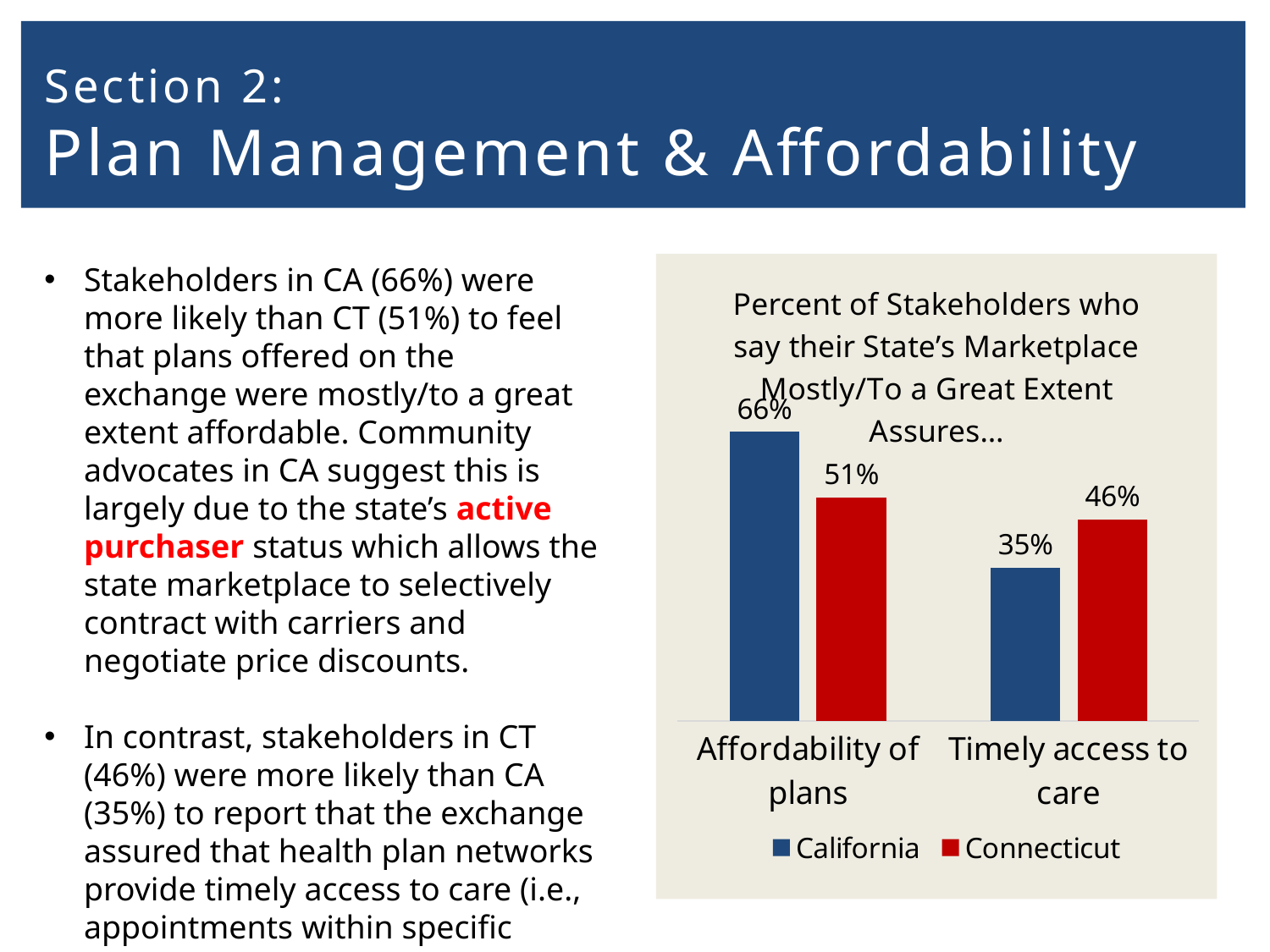
What type of chart is shown on the slide? Bar chart How many categories are shown on the x axis of the chart? 2 What percentage of Connecticut stakeholders say their marketplace assures affordability of plans? 51% Which bar in the chart has the lowest value? California, Timely access to care Which bar in the chart has the highest value? California, Affordability of plans What percentage of California stakeholders say their marketplace assures affordability of plans? 66% For timely access to care, which state has the larger value, California or Connecticut? Connecticut How many series does the chart legend list? 2 What is the value for Connecticut for timely access to care? 46% What is the difference between Connecticut and California for timely access to care? 11% What is the difference between California and Connecticut for affordability of plans? 15% What is the value for California for timely access to care? 35%